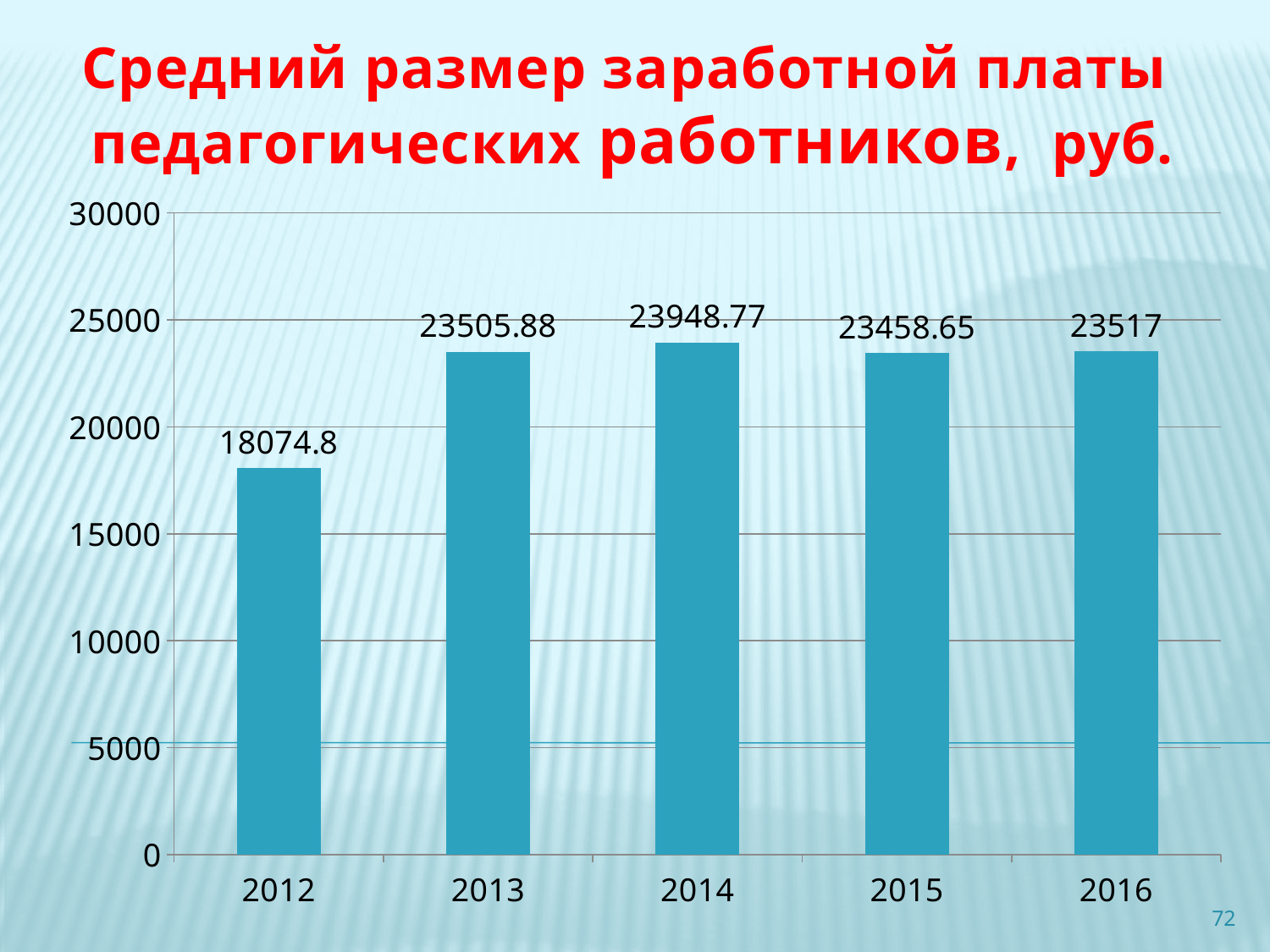
Which is larger, the value for 2013 or the value for 2012? 2013 Which year has the lowest value? 2012 What is the average salary value shown for 2012? 18074.8 What is the value shown for 2015? 23458.65 What is the value shown for 2016? 23517 What is the value shown for 2014? 23948.77 What is the difference between the values for 2014 and 2012? 5873.97 What is the difference between the values for 2016 and 2015? 58.35 Which year has the highest value? 2014 What kind of chart is shown on the slide? bar chart How many years are shown on the x axis? 5 Is the value for 2012 greater or less than 20000? less